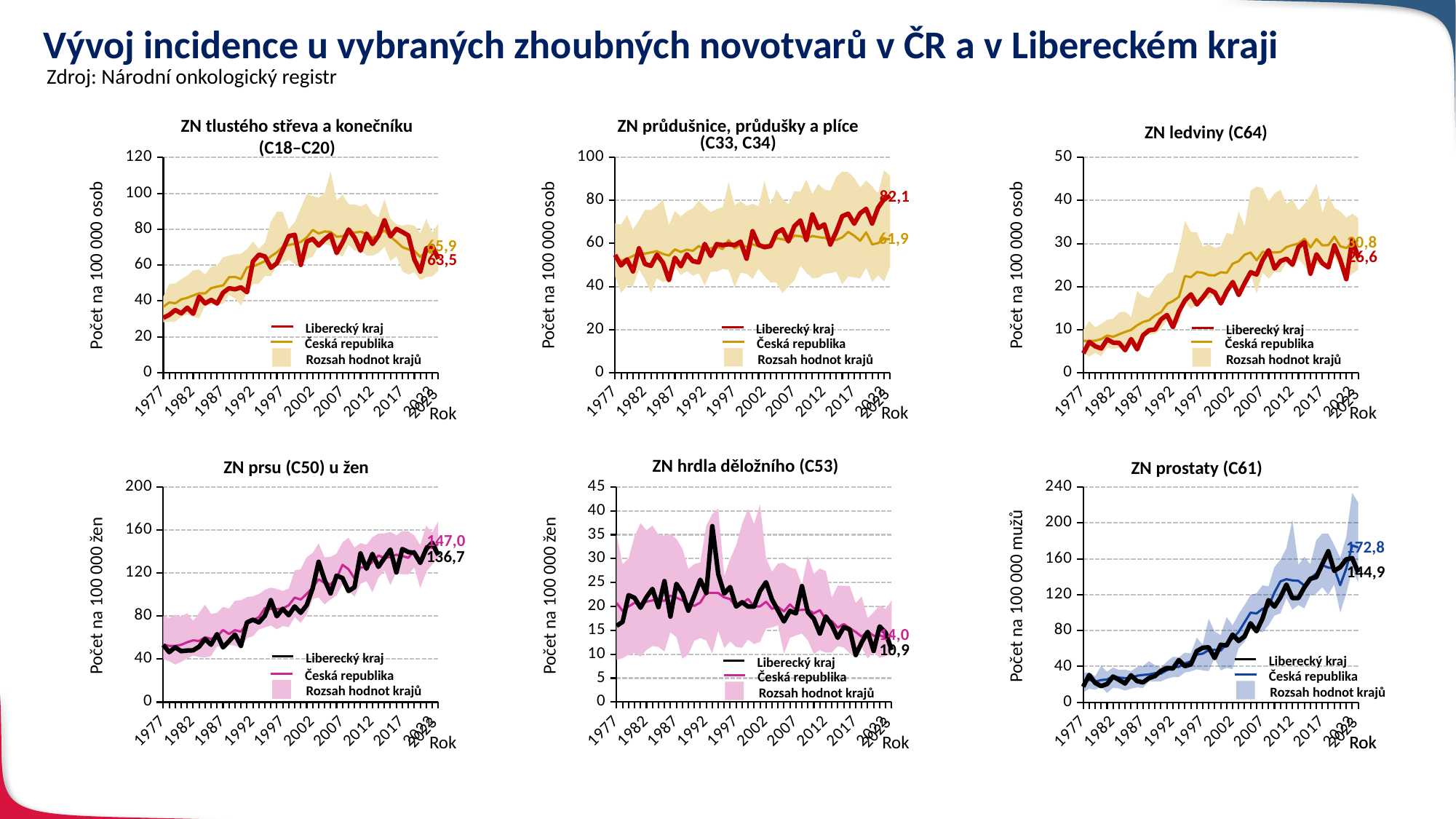
In the chart 'ZN prsu (C50) u žen', what is the final labelled value for Česká republika? 147,0 In the chart 'ZN hrdla děložního (C53)', what is the final labelled value for Liberecký kraj? 10,9 In the chart 'ZN prostaty (C61)', what is the difference between the final labelled values for Česká republika and Liberecký kraj? 27,9 In the chart 'ZN prostaty (C61)', what is the final labelled value for Česká republika? 172,8 In the chart 'ZN průdušnice, průdušky a plíce (C33, C34)', what is the final labelled value for Liberecký kraj? 82,1 How many entries does the legend list in the chart 'ZN ledviny (C64)'? 3 What kind of chart is 'ZN prostaty (C61)'? line chart In the chart 'ZN ledviny (C64)', what is the final labelled value for Česká republika? 30,8 In the chart 'ZN hrdla děložního (C53)', do the values generally rise or fall over the last two decades shown? fall In the chart 'ZN prostaty (C61)', what is the final labelled value for Liberecký kraj? 144,9 In the chart 'ZN prsu (C50) u žen', do the values generally rise or fall from 1977 to 2023? rise In the chart 'ZN průdušnice, průdušky a plíce (C33, C34)', which has the higher final labelled value, Liberecký kraj or Česká republika? Liberecký kraj